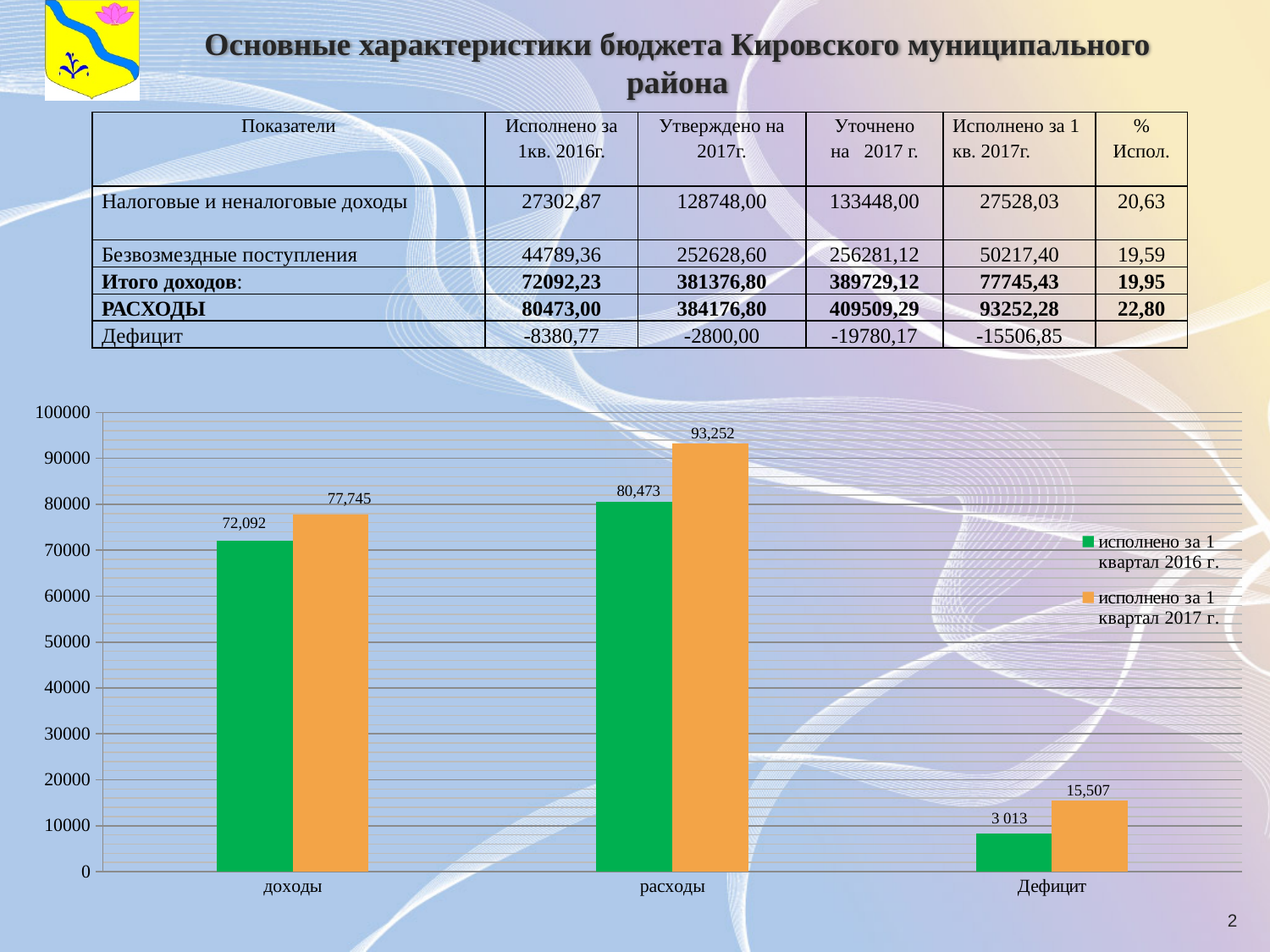
What is the value for расходы in the series исполнено за 1 квартал 2017 г.? 93,252 What is the value for Дефицит in the series исполнено за 1 квартал 2017 г.? 15,507 What is the value for расходы in the series исполнено за 1 квартал 2016 г.? 80,473 Is the value for Дефицит in the series исполнено за 1 квартал 2017 г. greater or less than 20000? less What kind of chart is shown on the slide? bar chart What is the difference between the расходы values for 1 квартал 2017 г. and 1 квартал 2016 г.? 12,779 What colour are the bars for the series исполнено за 1 квартал 2017 г.? orange What is the value for доходы in the series исполнено за 1 квартал 2017 г.? 77,745 How many series does the chart legend list? 2 Which category has the highest value in the series исполнено за 1 квартал 2017 г.? расходы What is the value for доходы in the series исполнено за 1 квартал 2016 г.? 72,092 How many categories are shown on the x axis of the chart? 3